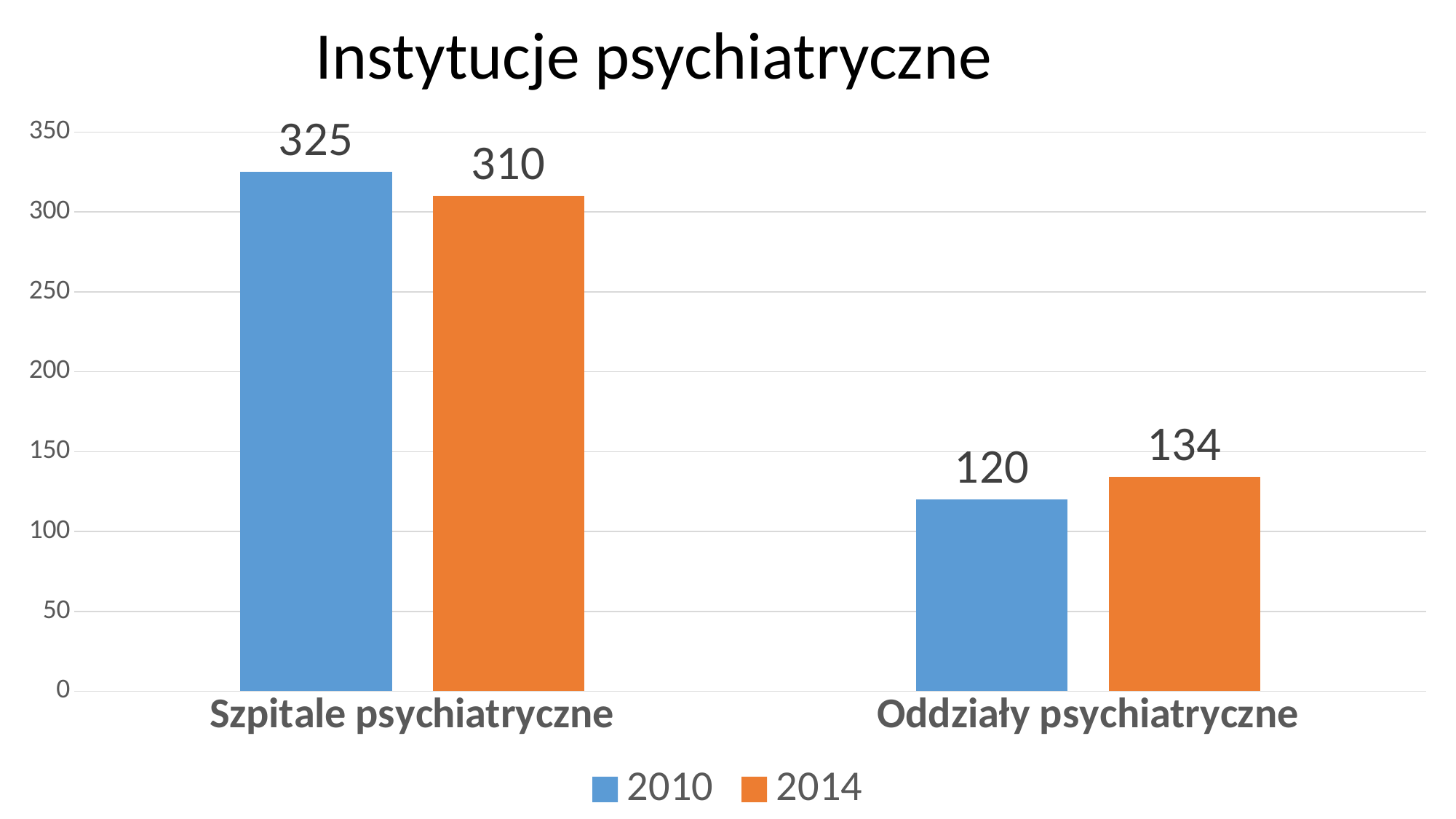
How many series does the legend list? 2 What is the difference between the 2010 and 2014 values for Szpitale psychiatryczne? 15 What is the value for Oddziały psychiatryczne in 2010? 120 What is the value for Szpitale psychiatryczne in 2010? 325 What is the value for Oddziały psychiatryczne in 2014? 134 What is the difference between the 2014 and 2010 values for Oddziały psychiatryczne? 14 Which category has the lowest value in 2014? Oddziały psychiatryczne What is the title of the chart? Instytucje psychiatryczne What is the value for Szpitale psychiatryczne in 2014? 310 Which category has the highest value in 2010? Szpitale psychiatryczne How many categories are shown on the x axis? 2 For Oddziały psychiatryczne, which year has the larger value, 2010 or 2014? 2014